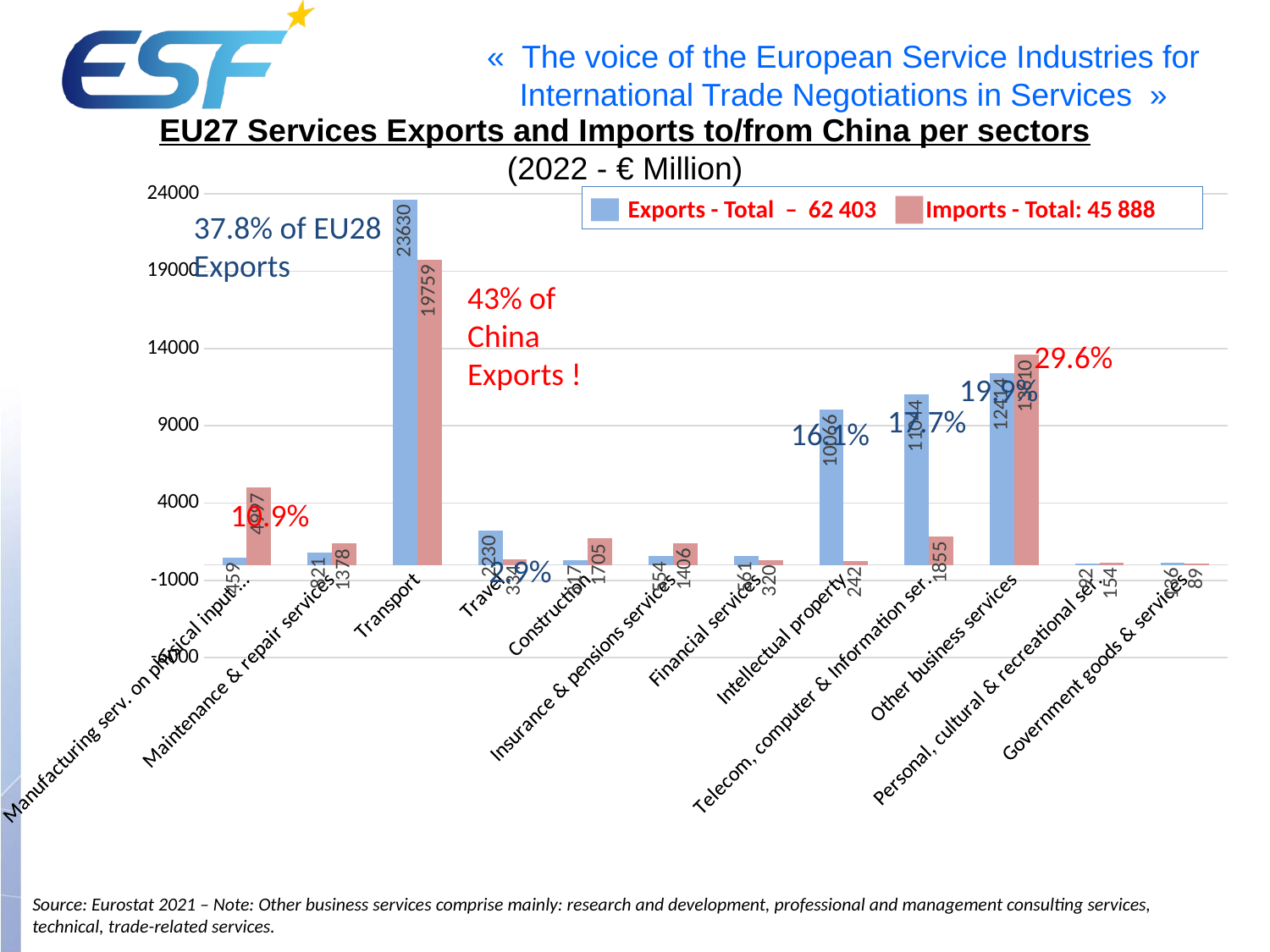
What is the Imports value for Other business services? 13610 What is the Exports value for Transport? 23630 According to the legend, what is the total for Exports? 62 403 How many series does the legend list? 2 For Other business services, which is larger, Exports or Imports? Imports What is the Imports value for Transport? 19759 What is the difference between Exports and Imports for Transport? 3871 Which sector has the highest Exports value? Transport What kind of chart is shown on the slide? bar chart Is the Exports value for Intellectual property greater or less than 9000? greater How many sector categories are plotted along the x axis? 12 What is the Imports value for Telecom, computer & Information services? 1855